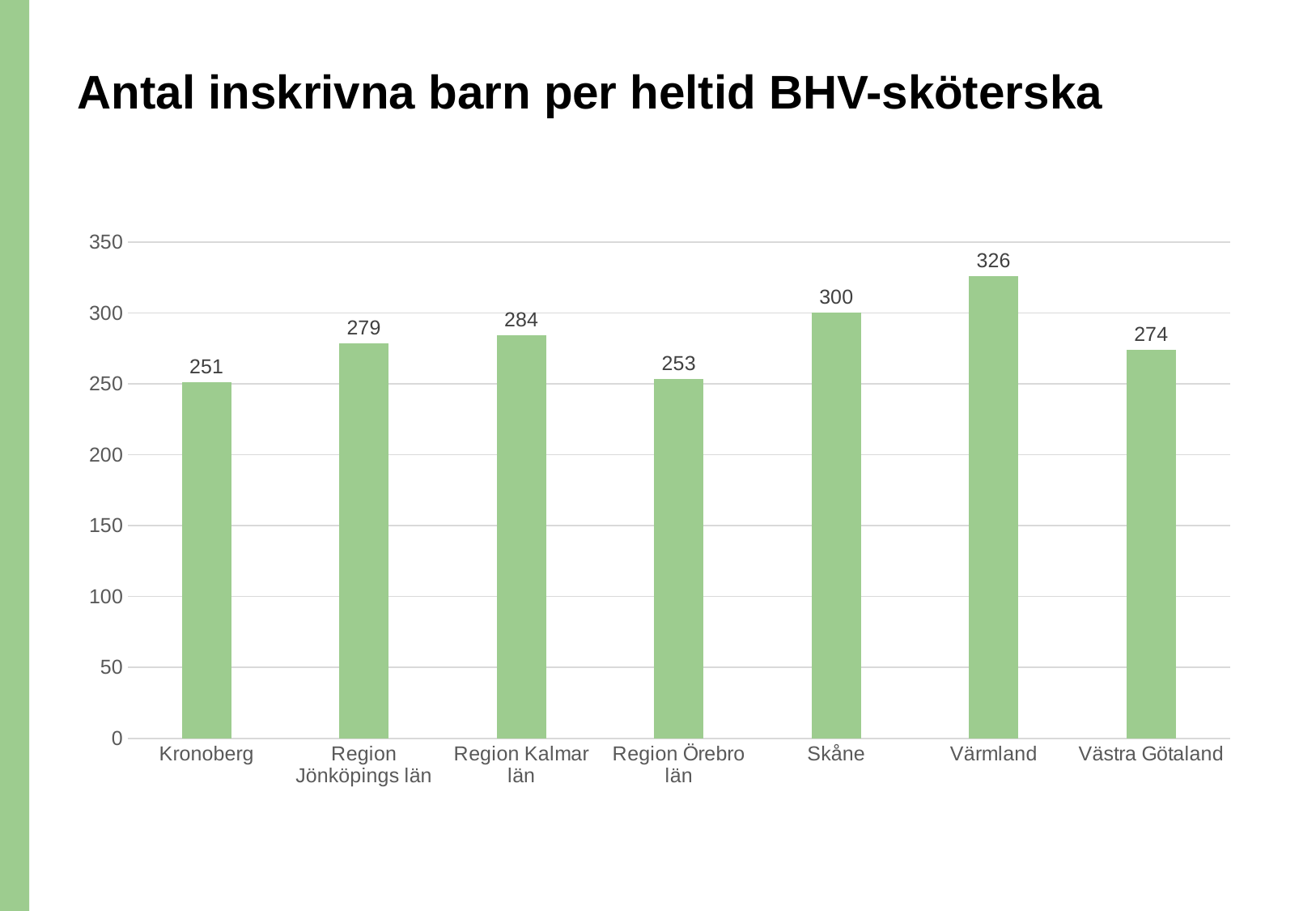
Which is larger, the value for Region Örebro län or the value for Västra Götaland? Västra Götaland What kind of chart is shown on the slide? bar chart What is the value for Kronoberg? 251 What is the difference between the values for Region Kalmar län and Region Jönköpings län? 5 What is the value for Skåne? 300 What is the difference between the values for Värmland and Kronoberg? 75 Is the value for Värmland greater or less than 300? greater What is the title of the chart? Antal inskrivna barn per heltid BHV-sköterska Which region has the lowest value? Kronoberg Which region has the highest value? Värmland What is the value for Västra Götaland? 274 How many regions are shown in the chart? 7